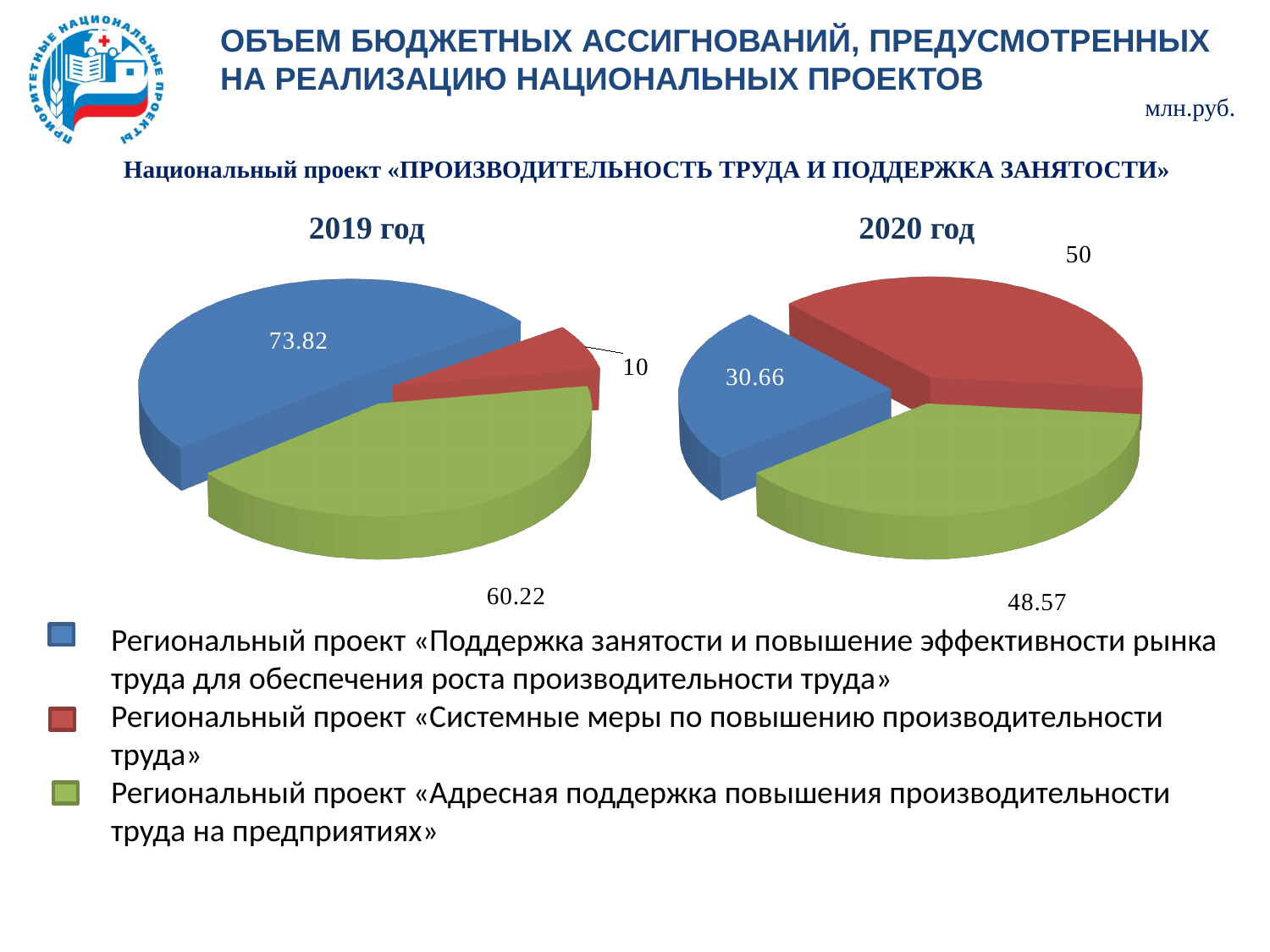
What is the total of all slices in the 2019 год pie chart? 144.04 In the 2020 год pie chart, what is the difference between the values for «Системные меры...» and «Поддержка занятости...»? 19.34 In the 2019 год pie chart, which regional project has the largest value? «Поддержка занятости и повышение эффективности рынка труда для обеспечения роста производительности труда» In the 2019 год pie chart, what is the value for the regional project «Системные меры по повышению производительности труда»? 10 How many slices does the 2020 год pie chart have? 3 In the 2020 год pie chart, which regional project has the smallest value? «Поддержка занятости и повышение эффективности рынка труда для обеспечения роста производительности труда» Which is larger: the value for «Поддержка занятости...» in the 2019 год chart or in the 2020 год chart? 2019 год In the 2020 год pie chart, what is the value for the regional project «Адресная поддержка повышения производительности труда на предприятиях»? 48.57 What type of chart is used for the 2019 год data? Pie chart In the 2020 год pie chart, what is the value for the regional project «Системные меры по повышению производительности труда»? 50 In the 2019 год pie chart, what is the difference between the values for «Поддержка занятости...» and «Адресная поддержка...»? 13.6 In the 2019 год pie chart, what is the value for the regional project «Поддержка занятости и повышение эффективности рынка труда для обеспечения роста производительности труда»? 73.82